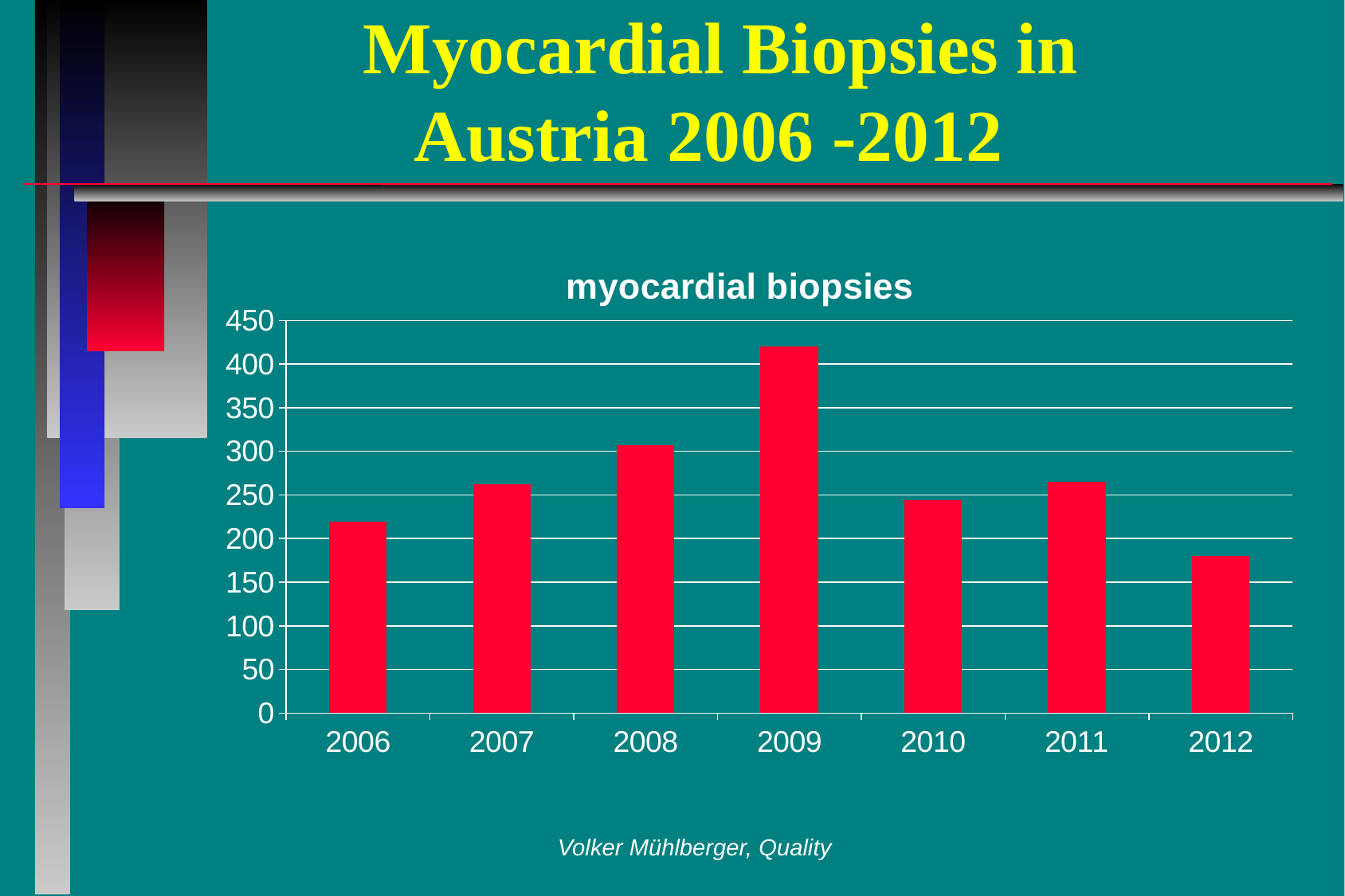
Which year has the larger value, 2006 or 2009? 2009 Is the value for 2012 greater or less than 200? less How many years are plotted on the chart? 7 Do the values rise or fall from 2006 to 2009? rise Which year has the highest number of myocardial biopsies? 2009 Is the value for 2009 greater or less than 400? greater What kind of chart is shown on the slide? bar chart Which year has the lowest number of myocardial biopsies? 2012 Is the value for 2006 greater or less than 250? less What is the title of the chart? myocardial biopsies Which year has the larger value, 2008 or 2010? 2008